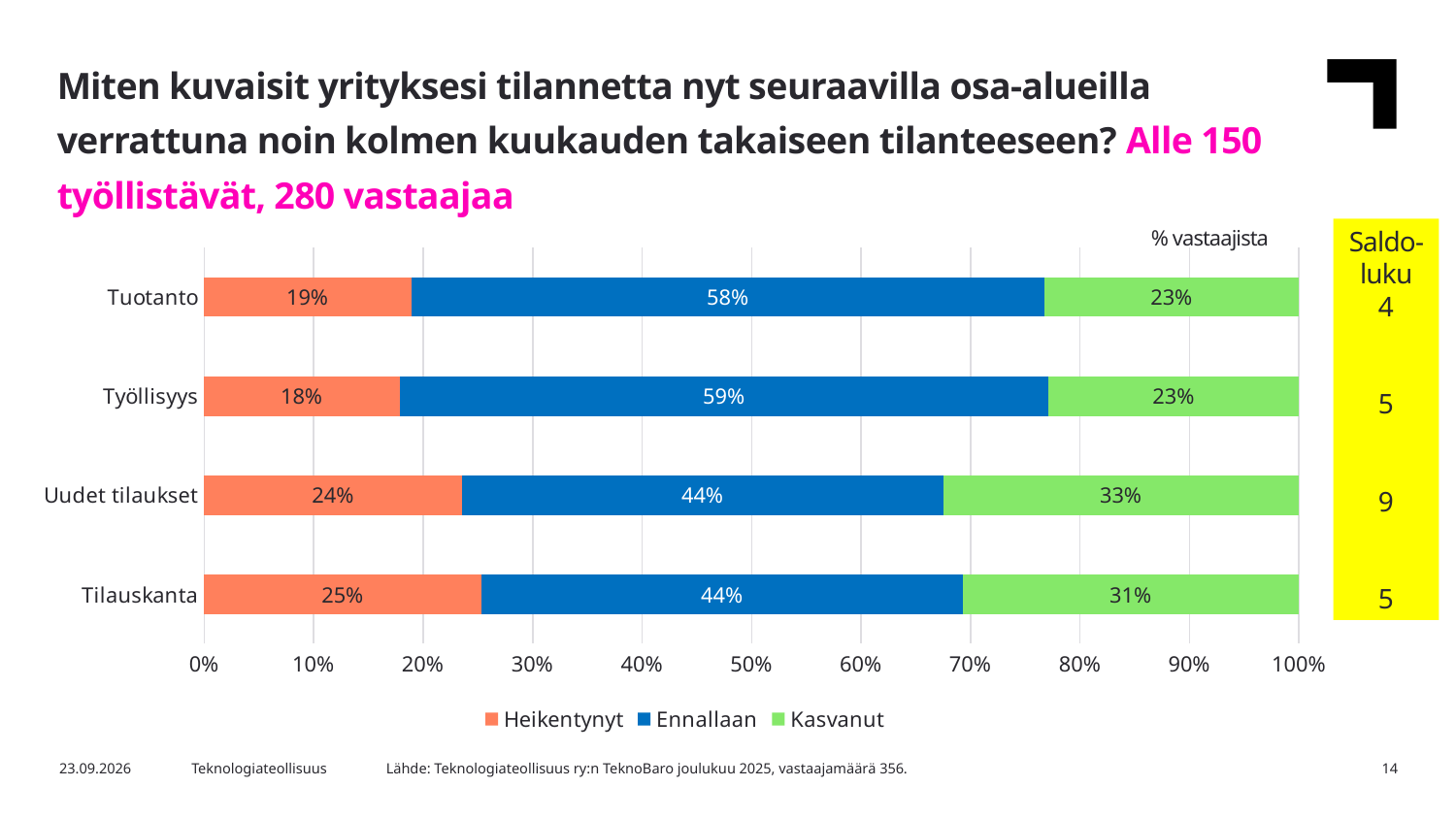
What is the "Kasvanut" value for Uudet tilaukset? 33% What percentage of respondents answered "Ennallaan" for Tuotanto? 58% What is the "Saldoluku" value shown for Uudet tilaukset? 9 Which category has the highest "Kasvanut" share? Uudet tilaukset Which series is shown in blue in the chart? Ennallaan What is the difference between the "Ennallaan" values for Työllisyys and Tilauskanta? 15 percentage points Which is larger: the "Kasvanut" value for Tilauskanta or for Tuotanto? Tilauskanta What kind of chart is shown on the slide? Stacked bar chart How many series does the legend list? 3 How many categories are shown on the y axis of the chart? 4 Which category has the lowest "Heikentynyt" share? Työllisyys What is the "Heikentynyt" value for Tilauskanta? 25%